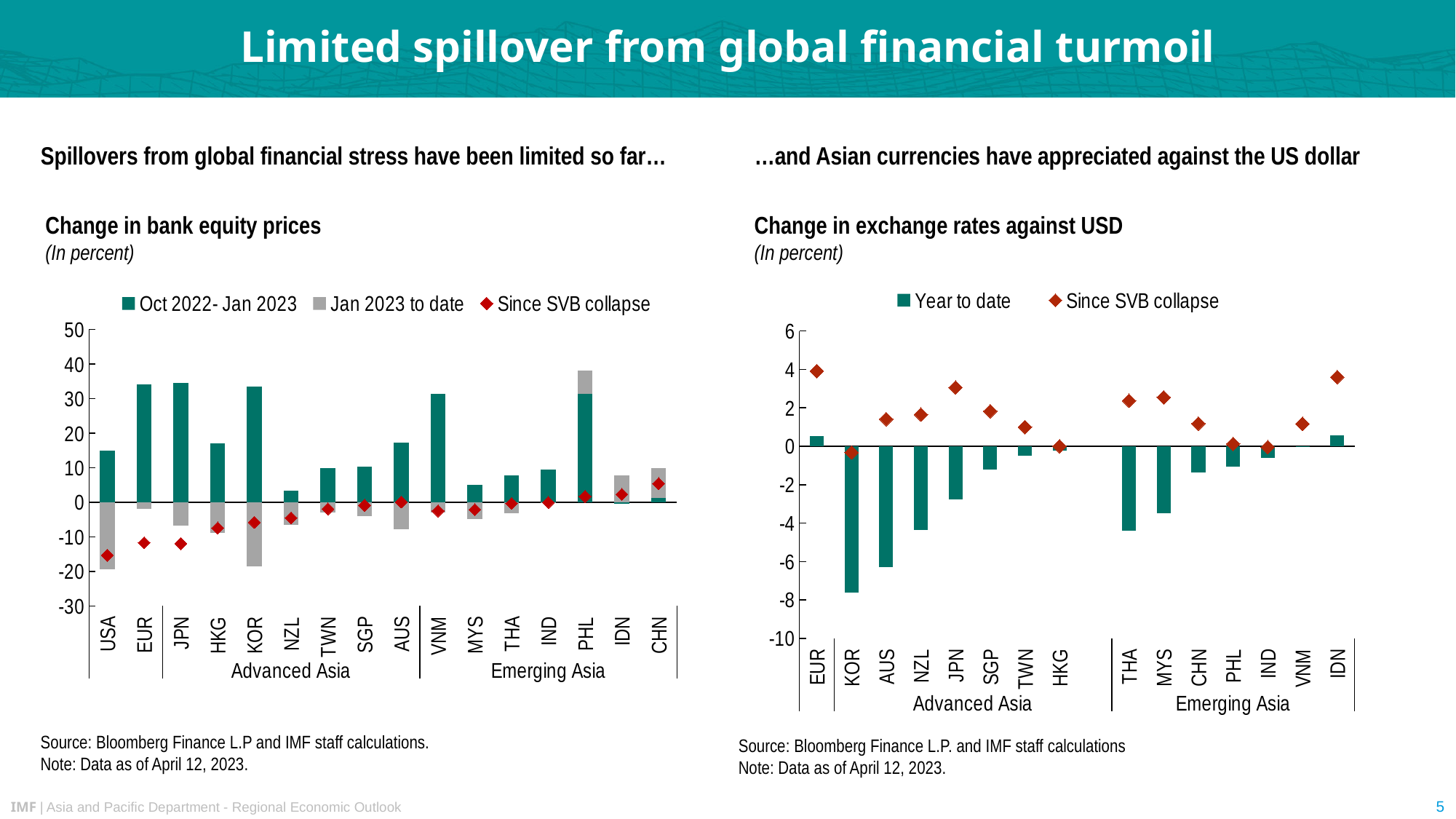
On the 'Change in bank equity prices' chart, is the 'Oct 2022- Jan 2023' value for USA greater or less than 10? greater On the 'Change in exchange rates against USD' chart, how many series does the legend list? 2 On the 'Change in exchange rates against USD' chart, which economy has the lowest 'Year to date' value? KOR On the 'Change in bank equity prices' chart, how many economies are shown on the x axis? 16 On the 'Change in exchange rates against USD' chart, is the 'Year to date' value for KOR greater or less than -6? less On the 'Change in bank equity prices' chart, which economy has the highest 'Since SVB collapse' value? CHN On the 'Change in bank equity prices' chart, which is larger for 'Oct 2022- Jan 2023': USA or VNM? VNM On the 'Change in bank equity prices' chart, which economy has the lowest 'Since SVB collapse' value? USA On the 'Change in bank equity prices' chart, how many series does the legend list? 3 On the 'Change in exchange rates against USD' chart, is the 'Since SVB collapse' value for EUR greater or less than 2? greater What kind of chart is the 'Change in exchange rates against USD' chart? Combination chart: bars for 'Year to date' with diamond markers for 'Since SVB collapse' On the 'Change in exchange rates against USD' chart, how many economies are shown on the x axis? 15